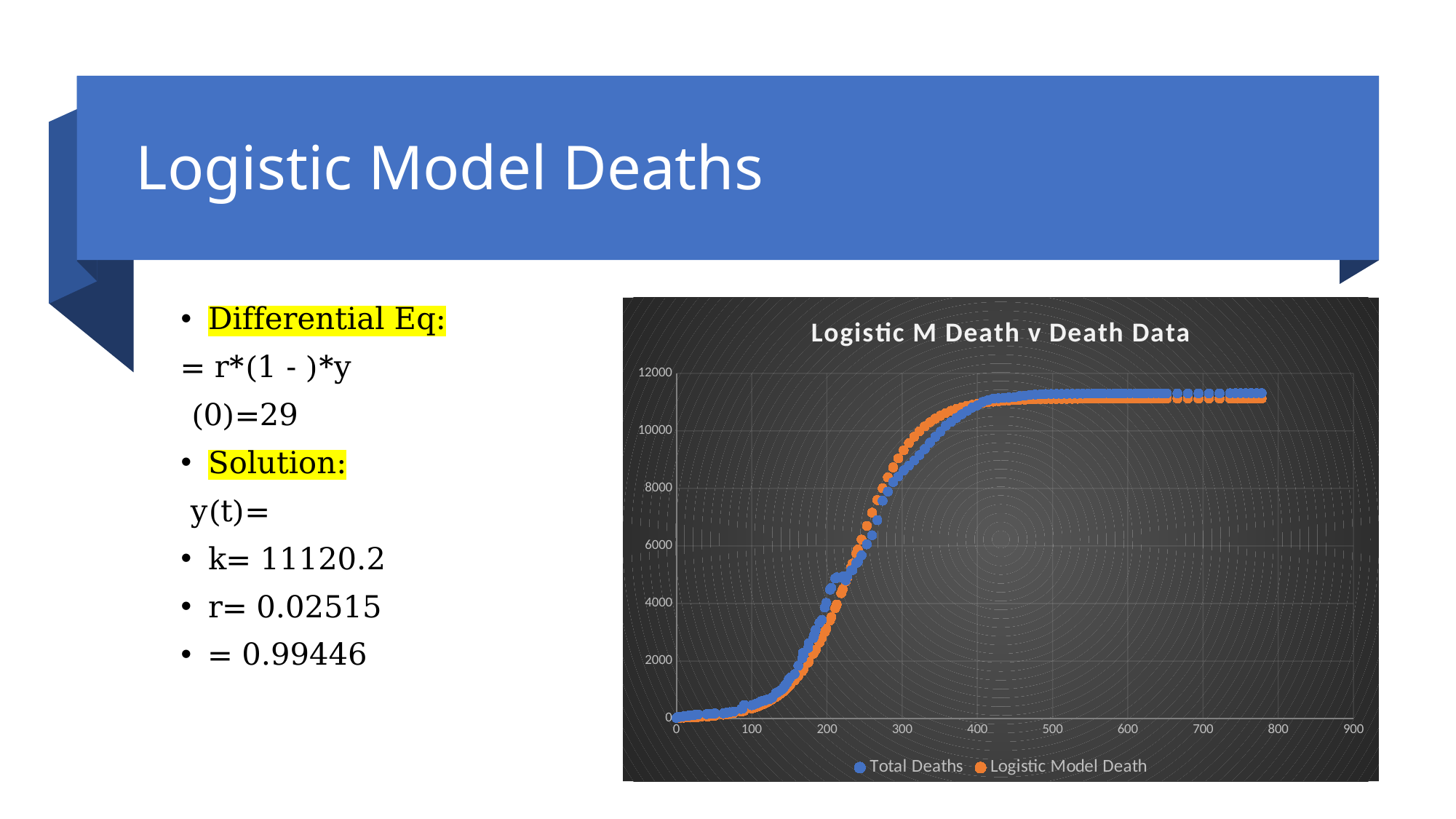
Is the value for Total Deaths at x = 400 greater or less than 10000? greater Which series is plotted in orange? Logistic Model Death What kind of chart is shown on the slide? scatter chart Do the Total Deaths values rise or fall as the x axis increases? rise What is the largest tick value shown on the x axis? 900 What is the title of the chart? Logistic M Death v Death Data Is the highest value for Total Deaths greater or less than 12000? less Is the value for Logistic Model Death at x = 600 greater or less than 10000? greater How many series does the chart legend list? 2 At x = 250, which series has the higher value, Total Deaths or Logistic Model Death? Logistic Model Death